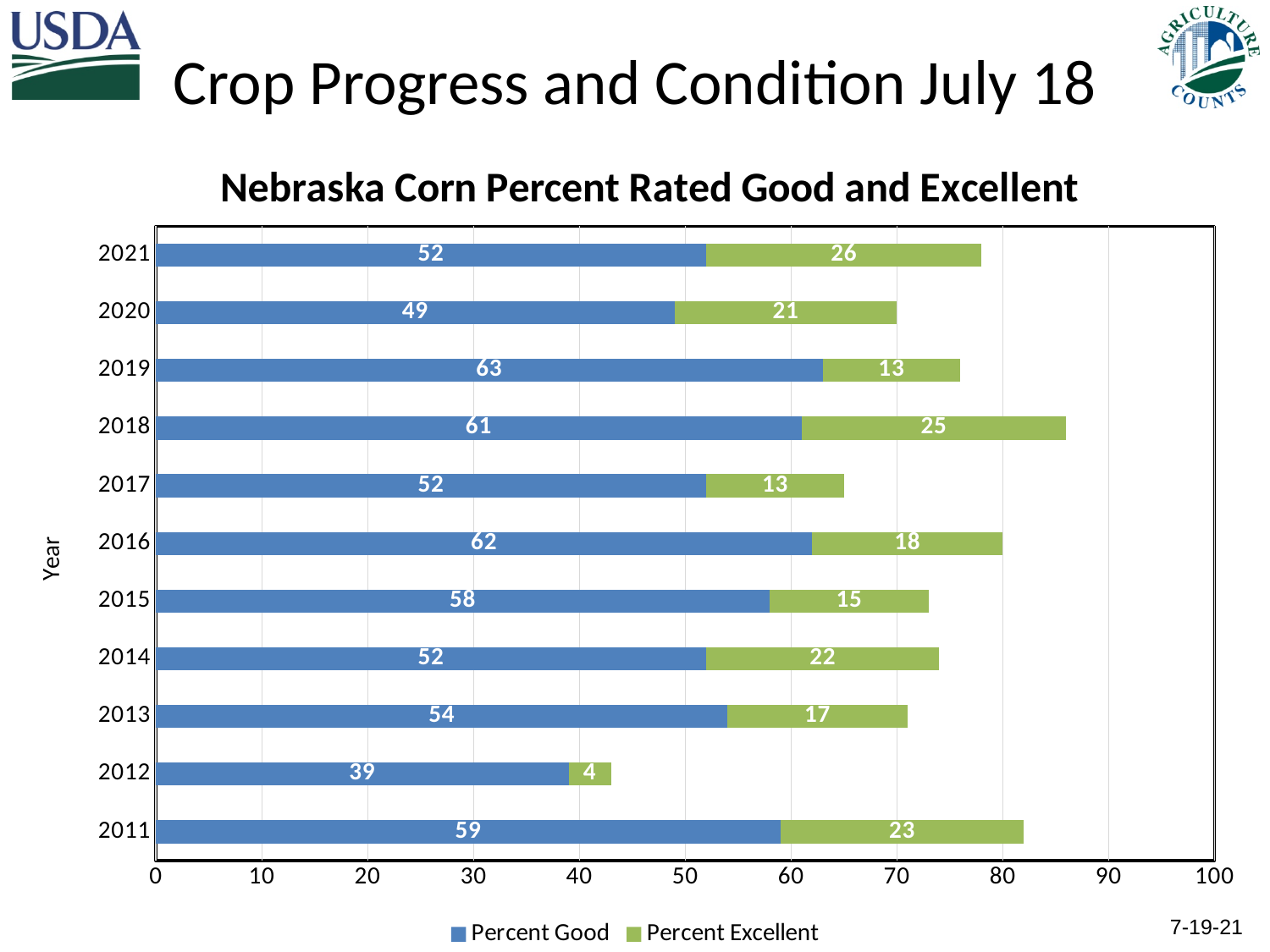
What is the difference between the Percent Good values for 2019 and 2020? 14 Is the total bar length for 2018 greater or less than 80? greater Which year has the lowest Percent Good value? 2012 How many series does the legend list? 2 Which year has the highest Percent Excellent value? 2021 How many years are shown on the chart? 11 What is the total of Percent Good and Percent Excellent for 2011? 82 What is the title of the chart? Nebraska Corn Percent Rated Good and Excellent What is the Percent Good value for 2019? 63 Which is larger, the Percent Excellent value for 2018 or for 2014? 2018 What kind of chart is shown on the slide? Stacked bar chart What is the Percent Excellent value for 2012? 4